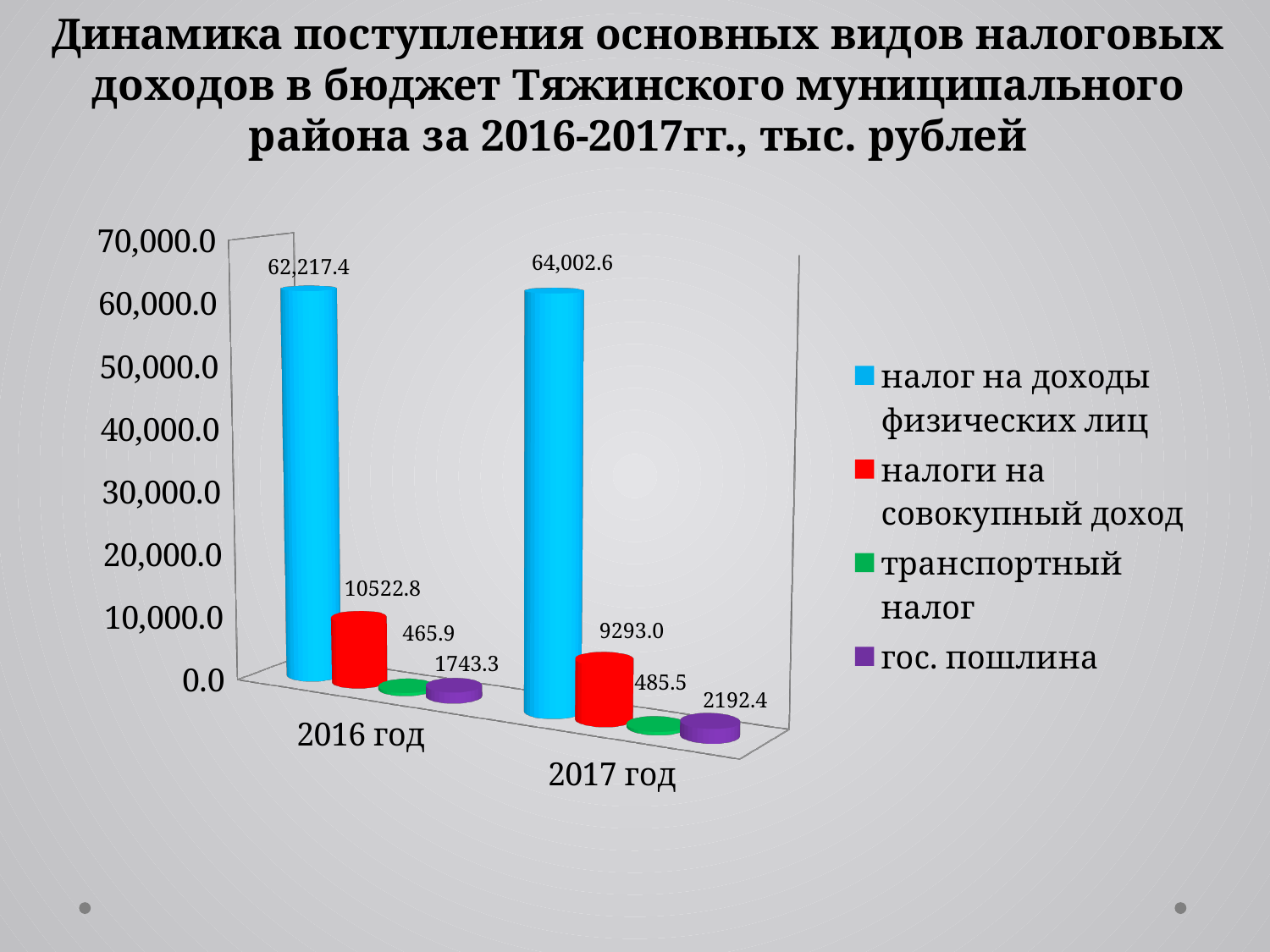
Which is larger: гос. пошлина in 2016 год or in 2017 год? 2017 год What is the difference between налоги на совокупный доход in 2016 год and 2017 год? 1229.8 How many series does the legend list? 4 Which series has the highest value for 2016 год? налог на доходы физических лиц Which series has the lowest value for 2017 год? транспортный налог What is the value of транспортный налог for 2017 год? 485.5 What type of chart is shown on the slide? bar chart What is the value of налог на доходы физических лиц for 2017 год? 64,002.6 What is the value of гос. пошлина for 2016 год? 1743.3 By how much did налог на доходы физических лиц increase from 2016 год to 2017 год? 1,785.2 What is the value of налоги на совокупный доход for 2016 год? 10522.8 What is the value of налог на доходы физических лиц for 2016 год? 62,217.4